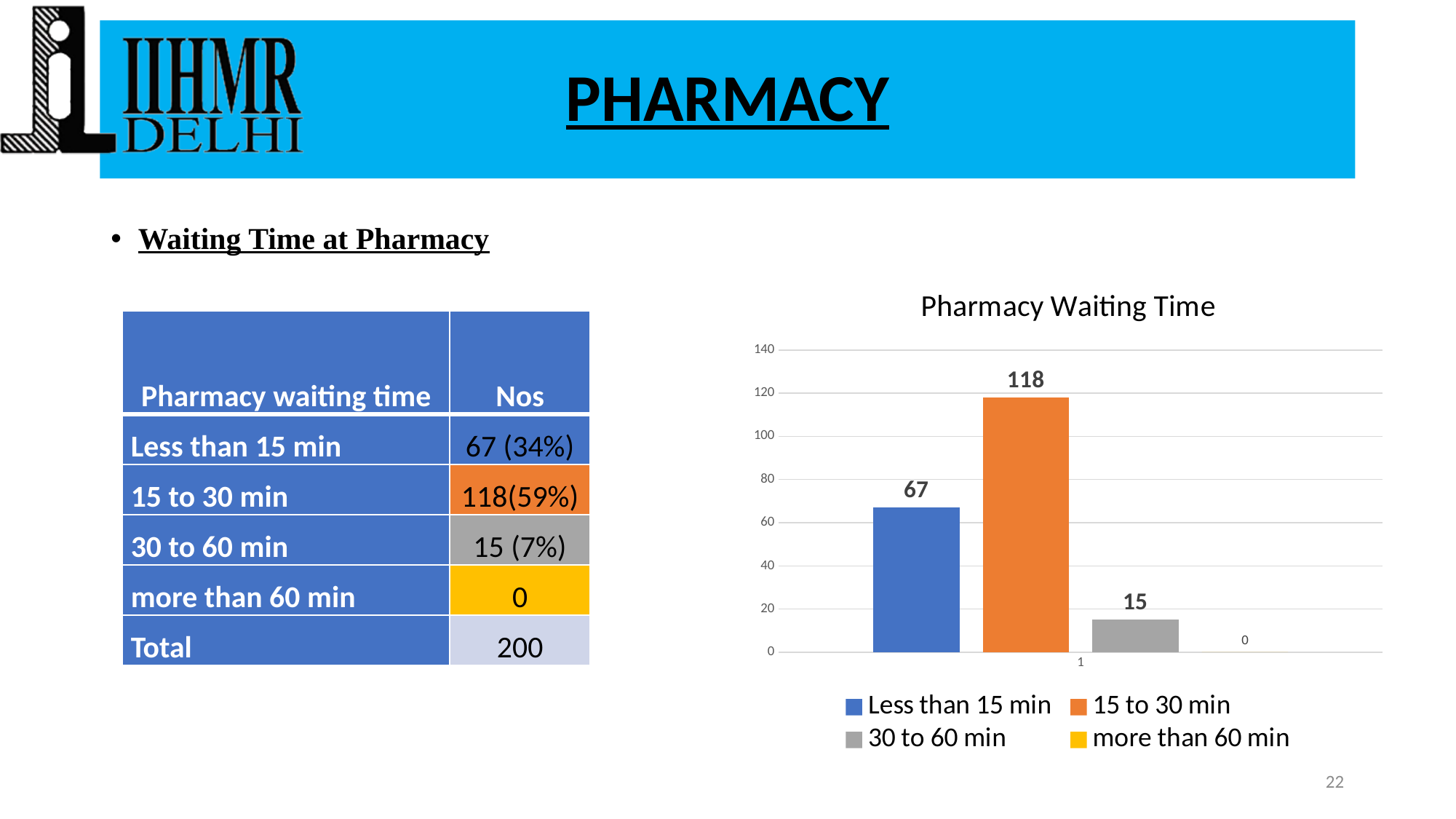
What is the value for more than 60 min in the Pharmacy Waiting Time chart? 0 What kind of chart is the Pharmacy Waiting Time chart? bar chart What colour is the bar for 15 to 30 min in the Pharmacy Waiting Time chart? orange Which is larger in the Pharmacy Waiting Time chart: Less than 15 min or 30 to 60 min? Less than 15 min What is the difference between the values for 15 to 30 min and Less than 15 min in the Pharmacy Waiting Time chart? 51 Is the value for 15 to 30 min in the Pharmacy Waiting Time chart greater or less than 100? greater What is the value for Less than 15 min in the Pharmacy Waiting Time chart? 67 How many series does the legend of the Pharmacy Waiting Time chart list? 4 Which series has the highest value in the Pharmacy Waiting Time chart? 15 to 30 min Which series has the lowest value in the Pharmacy Waiting Time chart? more than 60 min What is the value for 15 to 30 min in the Pharmacy Waiting Time chart? 118 What is the value for 30 to 60 min in the Pharmacy Waiting Time chart? 15